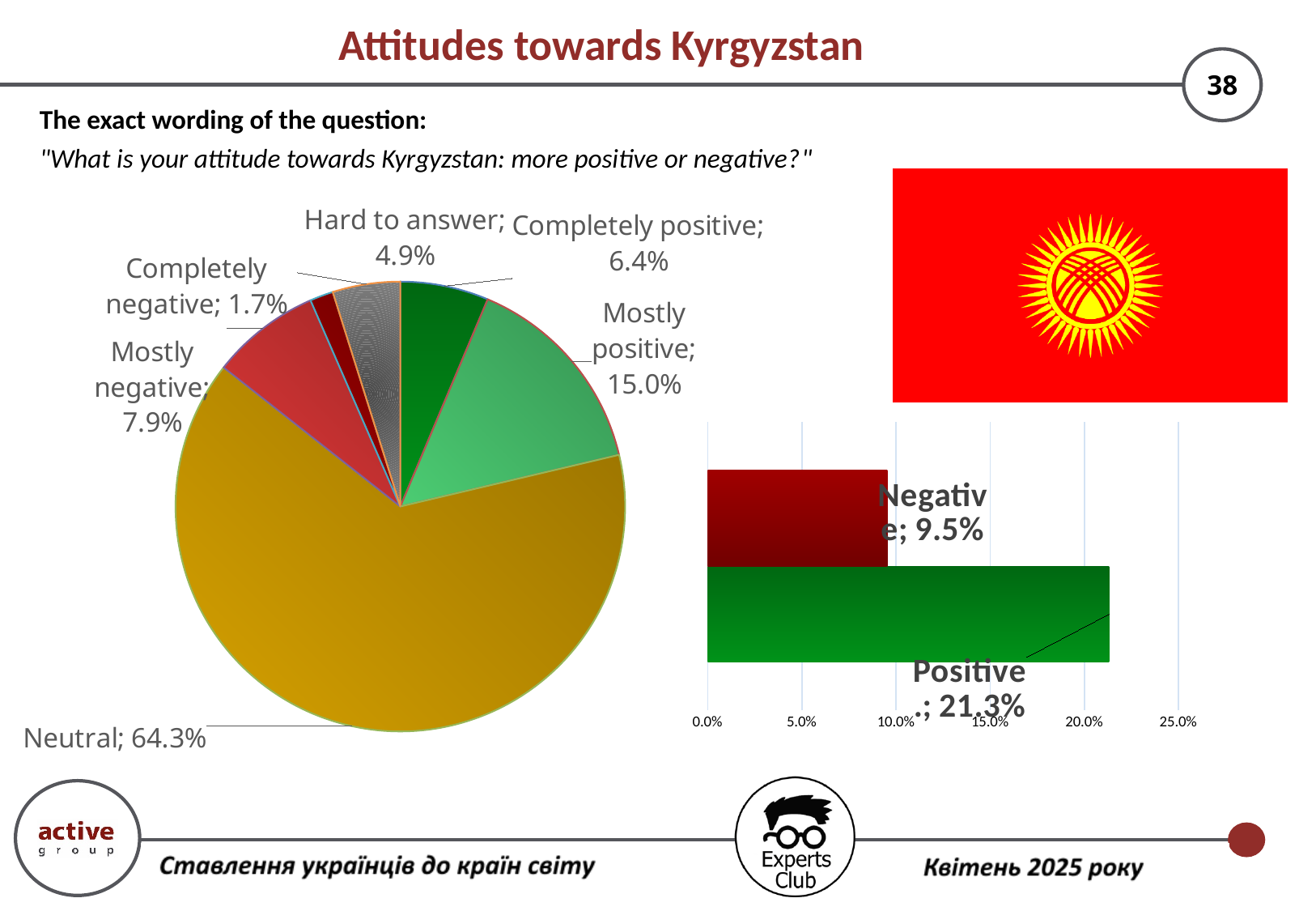
In the pie chart, how many categories are shown? 6 In the pie chart, which is larger: Mostly negative or Completely positive? Mostly negative In the pie chart, which category has the largest slice? Neutral In the pie chart, what is the value for Completely negative? 1.7% In the pie chart, what is the value for Hard to answer? 4.9% In the pie chart, what share of respondents answered Neutral? 64.3% In the bar chart on the right, what is the difference between Positive and Negative? 11.8% In the bar chart on the right, what is the value for Positive? 21.3% In the pie chart, what is the value for Mostly positive? 15.0% What type of chart is shown on the right side of the slide? Bar chart In the pie chart, which category has the smallest slice? Completely negative In the pie chart, what is the difference between Mostly positive and Completely positive? 8.6%